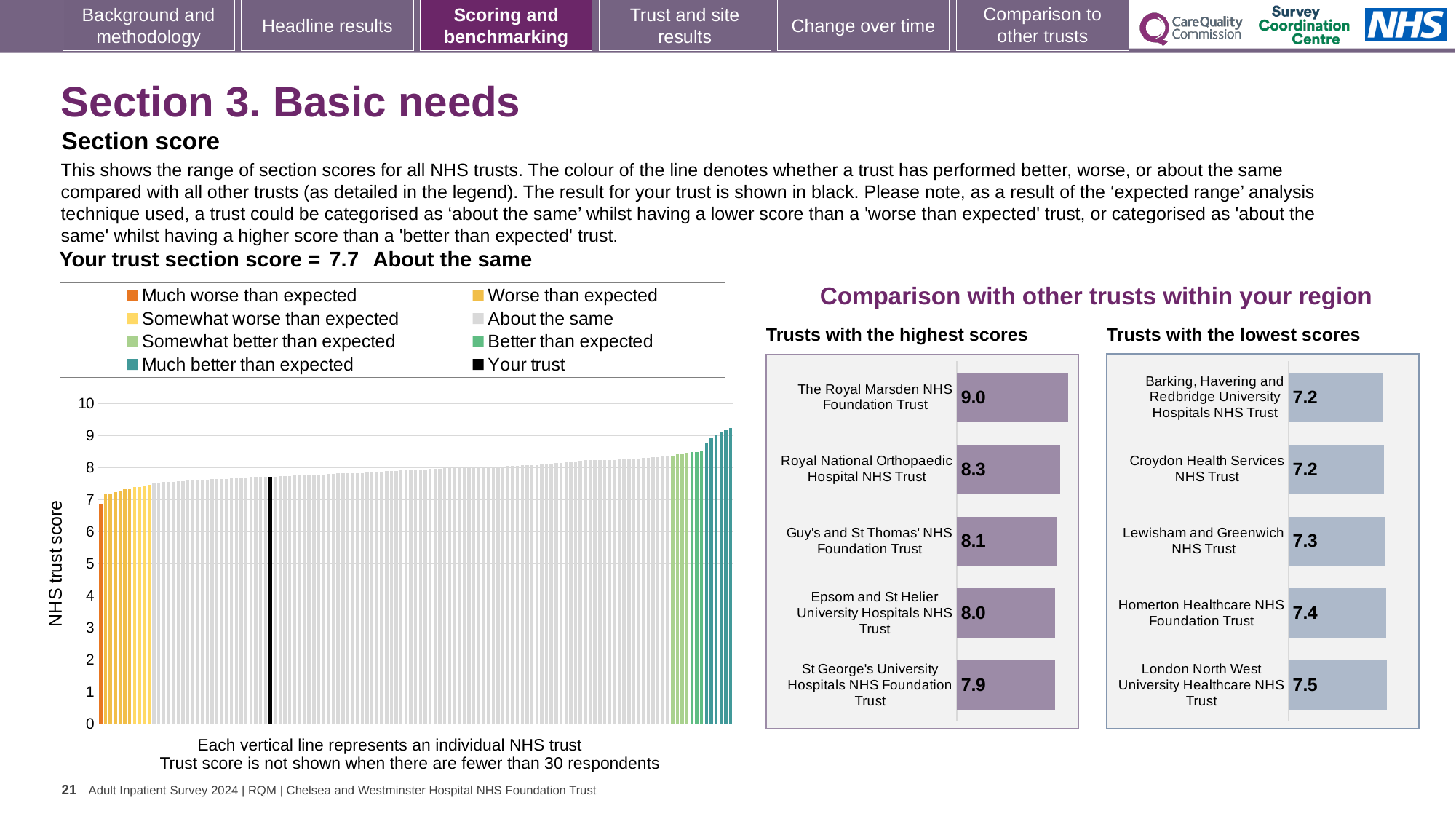
In the 'Trusts with the lowest scores' chart, which trust has the highest score? London North West University Healthcare NHS Trust How many entries does the legend of the main 'NHS trust score' chart list? 8 In the 'Trusts with the highest scores' chart, what is the difference between the scores of The Royal Marsden NHS Foundation Trust and St George's University Hospitals NHS Foundation Trust? 1.1 In the 'Trusts with the highest scores' chart, which trust has the highest score? The Royal Marsden NHS Foundation Trust In the 'Trusts with the lowest scores' chart, which has the larger score: Lewisham and Greenwich NHS Trust or Homerton Healthcare NHS Foundation Trust? Homerton Healthcare NHS Foundation Trust In the 'Trusts with the lowest scores' chart, what is the score for Homerton Healthcare NHS Foundation Trust? 7.4 What is the section score for your trust shown on the slide? 7.7 What type of chart is the main chart showing the range of section scores for all NHS trusts? Bar chart How many trusts are listed in the 'Trusts with the lowest scores' chart? 5 In the 'Trusts with the highest scores' chart, what is the score for The Royal Marsden NHS Foundation Trust? 9.0 In the 'Trusts with the highest scores' chart, what is the score for Epsom and St Helier University Hospitals NHS Trust? 8.0 In the main 'NHS trust score' chart, do the bar values rise or fall from left to right? Rise